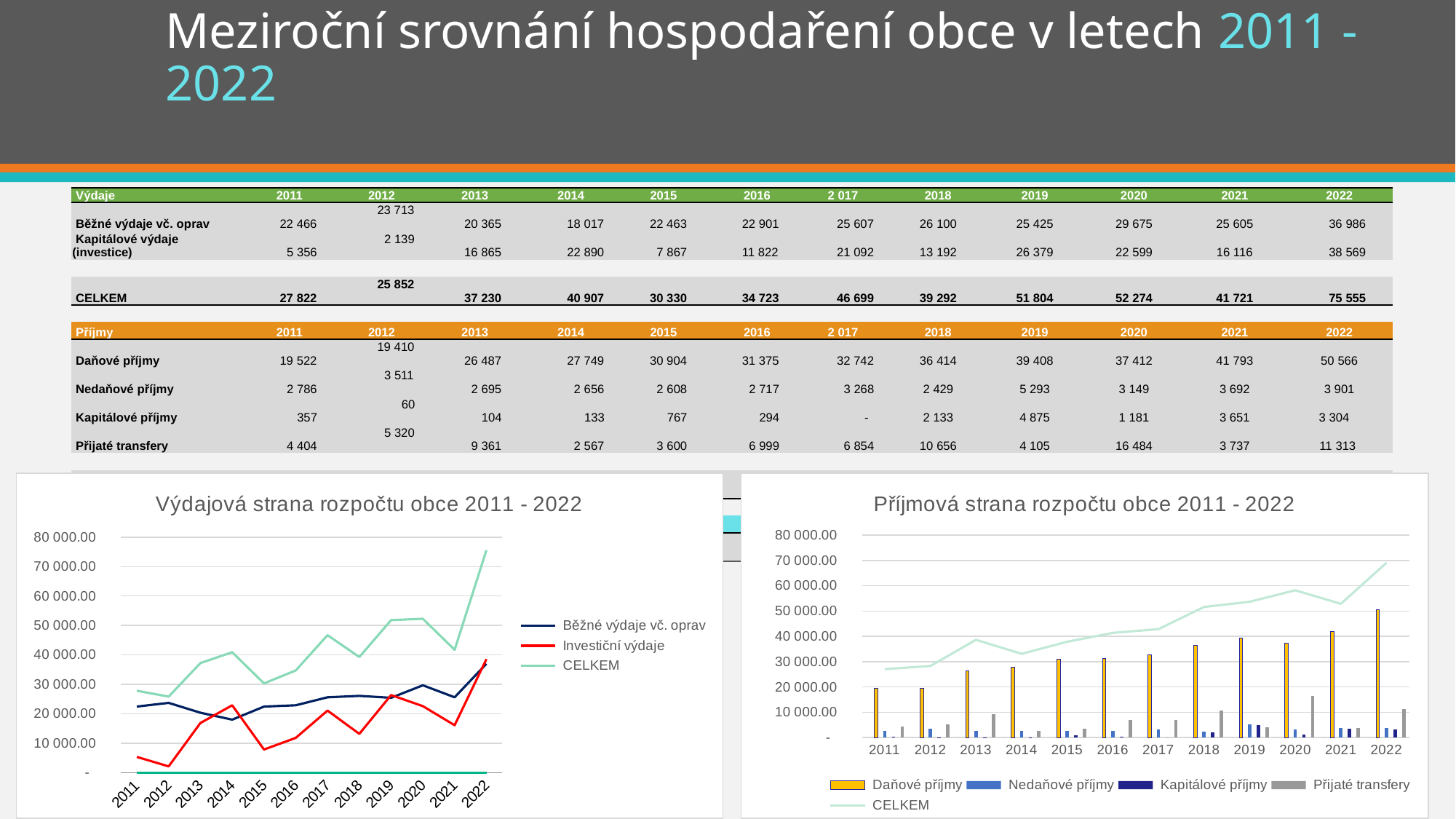
In the chart 'Příjmová strana rozpočtu obce 2011 - 2022', how many series does the legend list? 5 In the chart 'Výdajová strana rozpočtu obce 2011 - 2022', is the CELKEM value for 2022 greater or less than 70 000.00? greater In the chart 'Příjmová strana rozpočtu obce 2011 - 2022', in which year is the Přijaté transfery bar highest? 2020 What is the title of the chart on the left of the slide? Výdajová strana rozpočtu obce 2011 - 2022 In the chart 'Výdajová strana rozpočtu obce 2011 - 2022', in which year is the CELKEM line highest? 2022 In the chart 'Výdajová strana rozpočtu obce 2011 - 2022', which is larger for Běžné výdaje vč. oprav: 2013 or 2014? 2013 In the chart 'Výdajová strana rozpočtu obce 2011 - 2022', in which year is the Investiční výdaje line lowest? 2012 In the chart 'Výdajová strana rozpočtu obce 2011 - 2022', how many series does the legend list? 3 In the chart 'Příjmová strana rozpočtu obce 2011 - 2022', how many years are shown on the x axis? 12 In the chart 'Příjmová strana rozpočtu obce 2011 - 2022', is the CELKEM value for 2022 greater or less than 60 000.00? greater In the chart 'Výdajová strana rozpočtu obce 2011 - 2022', is the Investiční výdaje value for 2015 greater or less than 10 000.00? less In the chart 'Příjmová strana rozpočtu obce 2011 - 2022', in which year is the Daňové příjmy bar highest? 2022